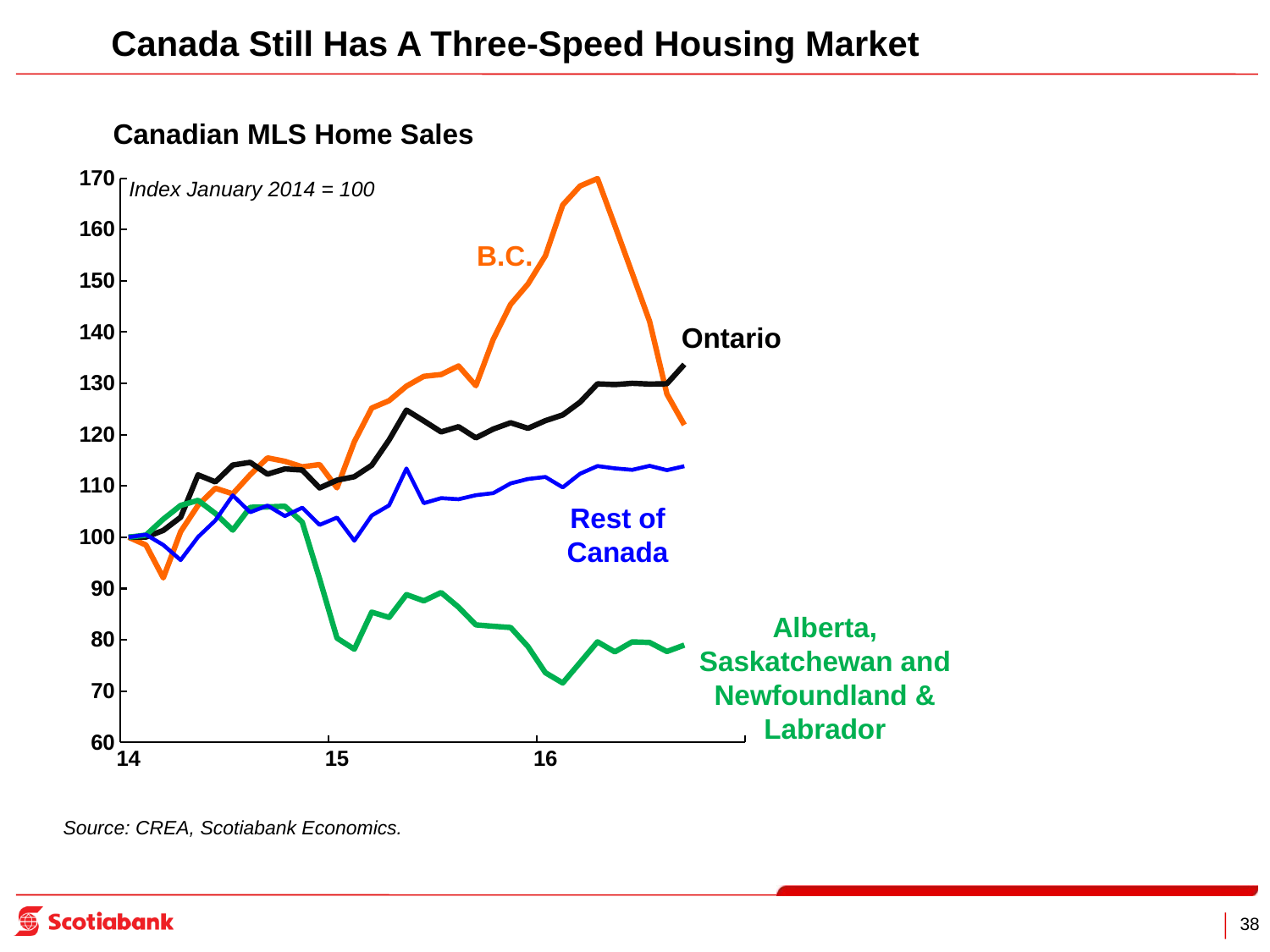
Is the value of the Ontario series at the end of the period greater or less than 120? greater What is the base period of the index used on the chart? January 2014 = 100 Which series reaches the highest value anywhere on the chart? B.C. Which series is the lowest at the end of the period shown? Alberta, Saskatchewan and Newfoundland & Labrador Is the value of the B.C. series at the end of the period greater or less than 130? less Which series is higher at the end of the period shown, Ontario or B.C.? Ontario Is the peak value of the B.C. series greater or less than 160? greater Does the Alberta, Saskatchewan and Newfoundland & Labrador series rise or fall overall from the start to the end of the period? fall What kind of chart is shown on the slide? Line chart How many series are plotted on the chart? 4 What is the title of the chart? Canadian MLS Home Sales